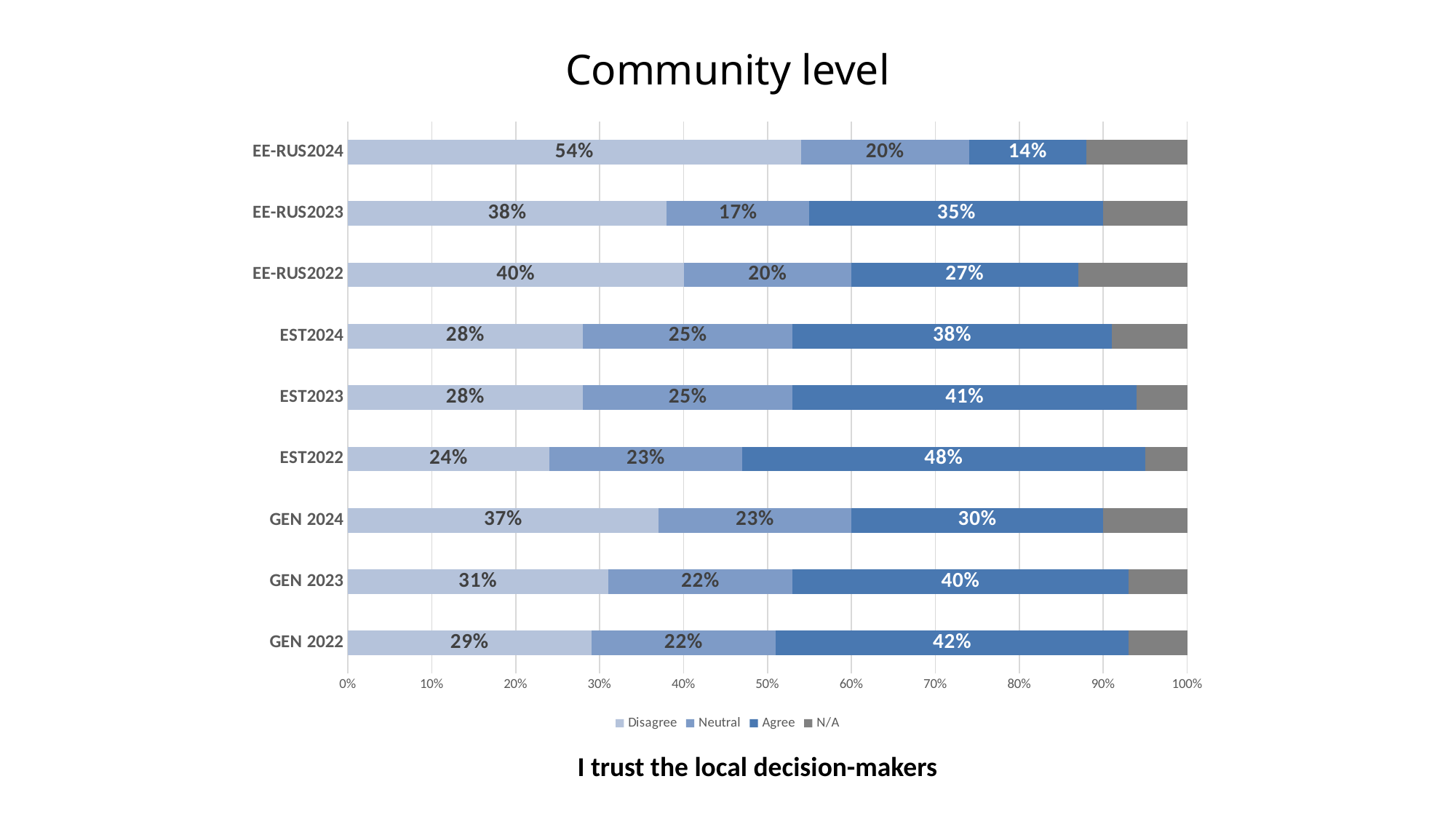
What is the Neutral value for GEN 2023? 22% What kind of chart is shown on the slide? Stacked bar chart Which category has the lowest Agree value? EE-RUS2024 Which category has the highest Disagree value? EE-RUS2024 What is the difference between the Disagree values for EE-RUS2024 and EE-RUS2023? 16 Which category has the highest Agree value? EST2022 How many categories (bars) are shown in the chart? 9 Which has a larger Agree value, GEN 2022 or GEN 2024? GEN 2022 What is the Agree value for EST2022? 48% How many percentage points higher is the Agree value for EST2022 than for EST2024? 10 What percentage of EE-RUS2024 respondents disagree? 54% How many series does the legend list? 4